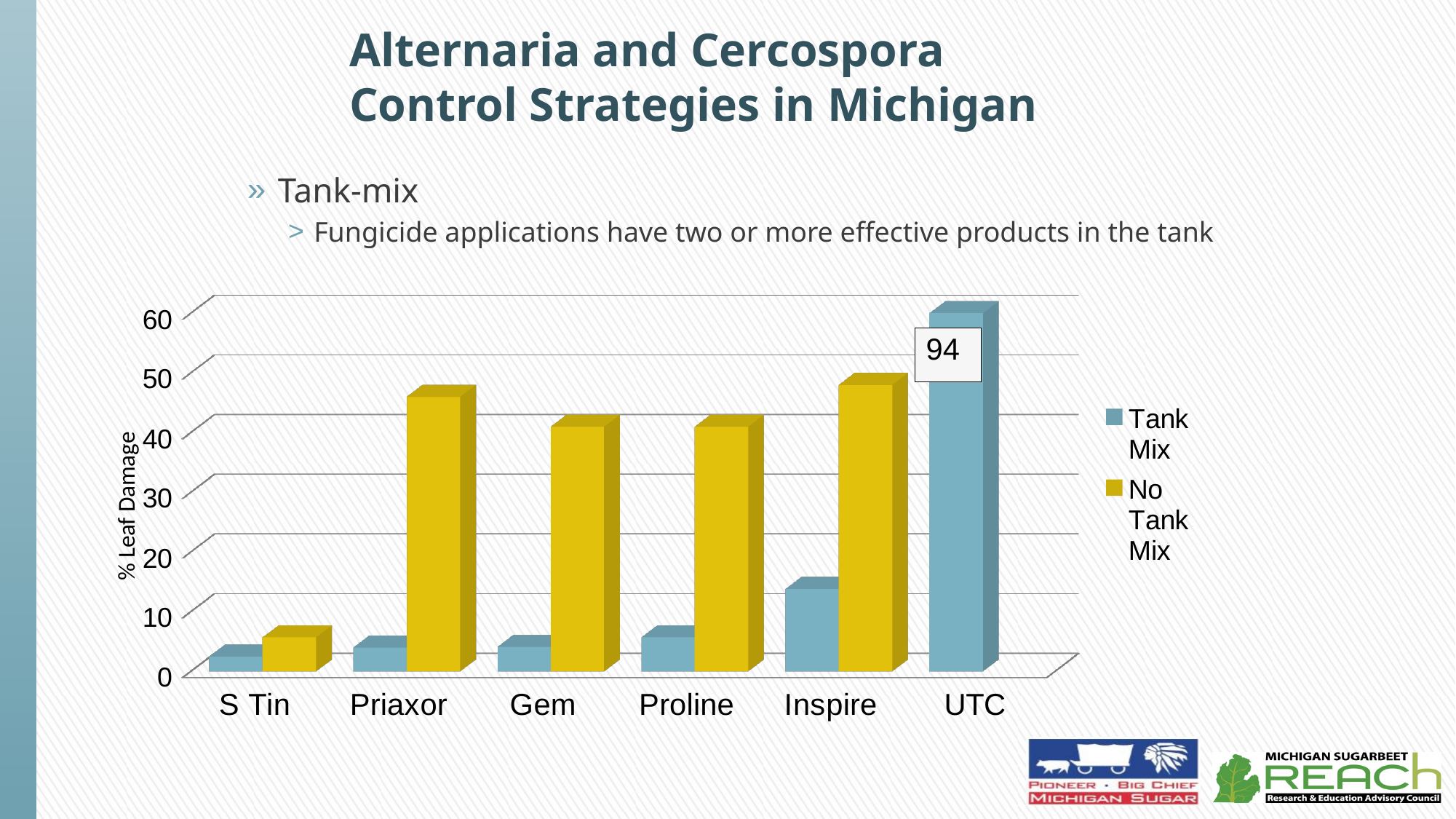
What kind of chart is shown on the slide? Bar chart Which is larger: the Tank Mix value for Inspire or the Tank Mix value for Proline? Inspire How many series does the chart's legend list? 2 Is the No Tank Mix value for S Tin greater or less than 10? less Is the No Tank Mix value for Priaxor greater or less than 40? greater Which category has the lowest No Tank Mix bar? S Tin Is the Tank Mix value for Inspire greater or less than 20? less How many treatment categories are shown on the x axis of the chart? 6 Which category has the highest Tank Mix bar? UTC What is the label on the vertical axis of the chart? % Leaf Damage What is the % Leaf Damage value labelled on the Tank Mix bar for UTC? 94 Which category has the lowest Tank Mix bar? S Tin